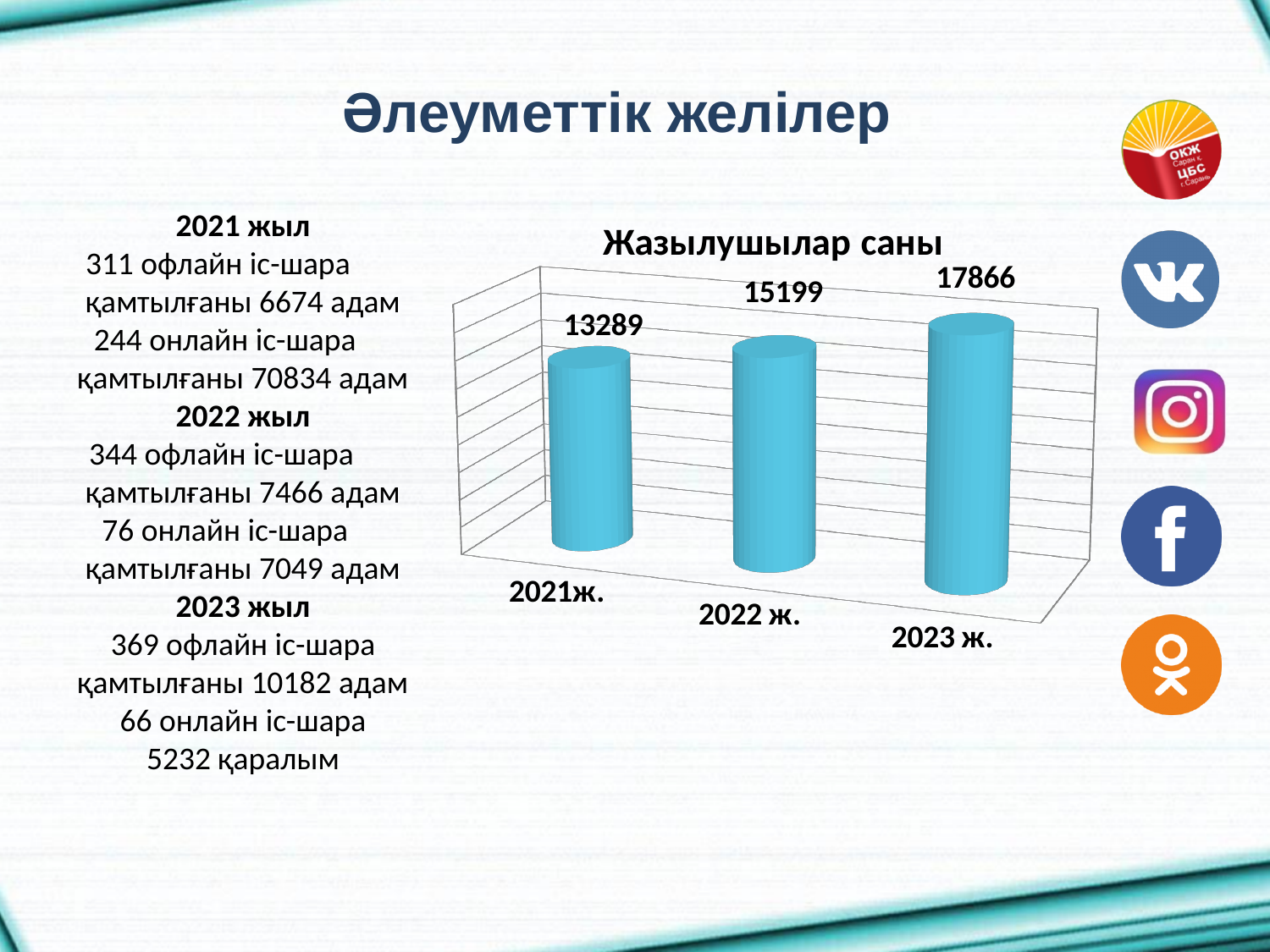
What is the title of the chart? Жазылушылар саны What is the difference between the values for 2022 ж. and 2021ж.? 1910 How many categories are shown in the chart? 3 Which year has the highest value in the chart? 2023 ж. What is the value for 2023 ж. in the chart? 17866 What is the difference between the values for 2023 ж. and 2021ж.? 4577 Do the values rise or fall from 2021ж. to 2023 ж.? rise What is the value for 2022 ж. in the chart? 15199 Which is larger, the value for 2022 ж. or the value for 2023 ж.? 2023 ж. What is the value for 2021ж. in the chart? 13289 Which year has the lowest value in the chart? 2021ж. What kind of chart is shown on the slide? bar chart